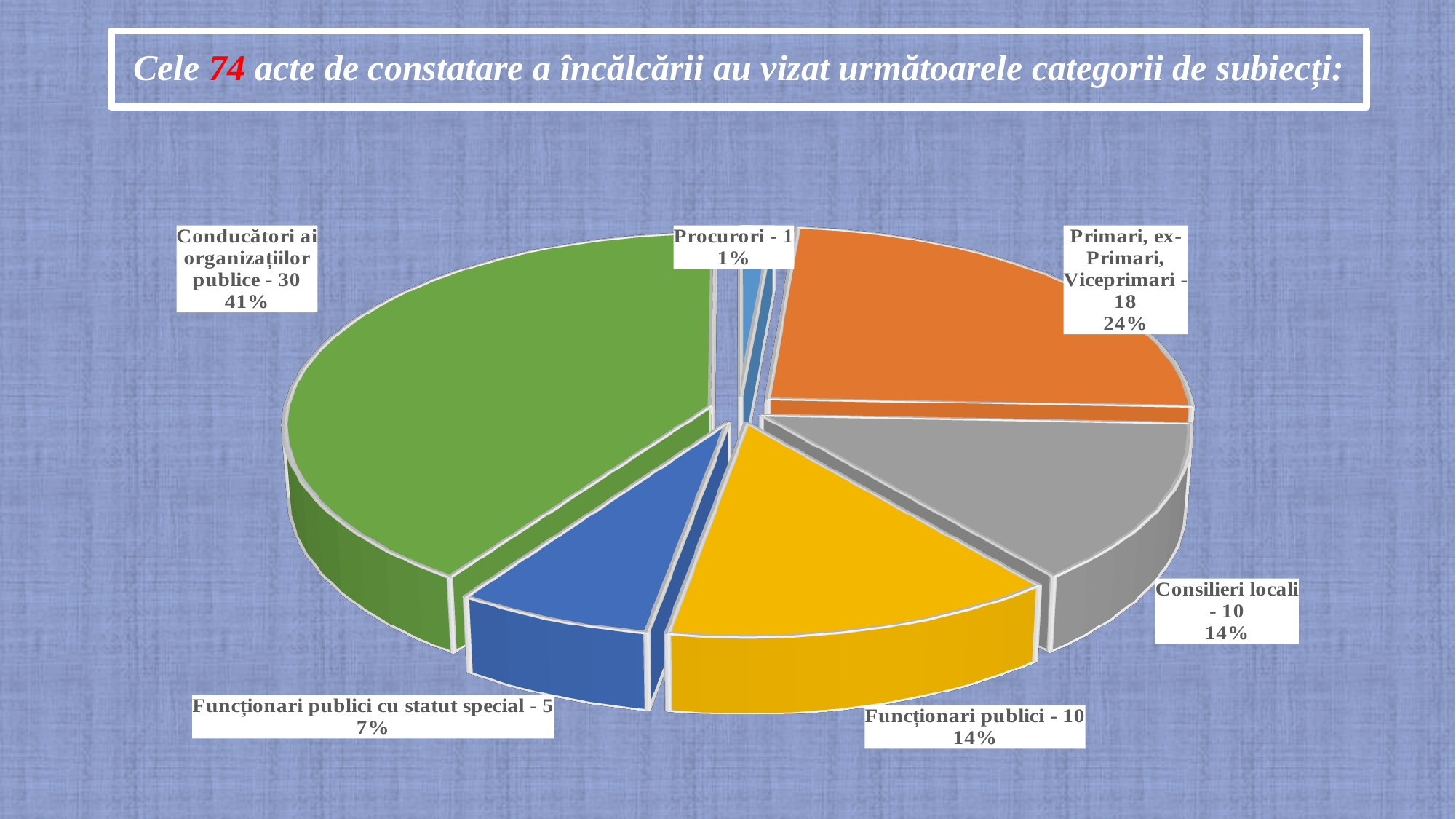
What is the difference between the values for "Conducători ai organizațiilor publice" and "Primari, ex-Primari, Viceprimari"? 12 What percentage is shown for "Procurori"? 1% What is the value for "Funcționari publici cu statut special"? 5 What colour is the slice for "Funcționari publici"? yellow Which category has the largest slice of the pie? Conducători ai organizațiilor publice What is the total number of acts mentioned in the slide title? 74 What share of the pie does "Primari, ex-Primari, Viceprimari" represent? 24% Which category has the smallest slice of the pie? Procurori How many acts are attributed to "Conducători ai organizațiilor publice"? 30 Which is larger, the value for "Consilieri locali" or the value for "Funcționari publici cu statut special"? Consilieri locali What kind of chart is shown on the slide? pie chart How many categories does the pie chart have? 6